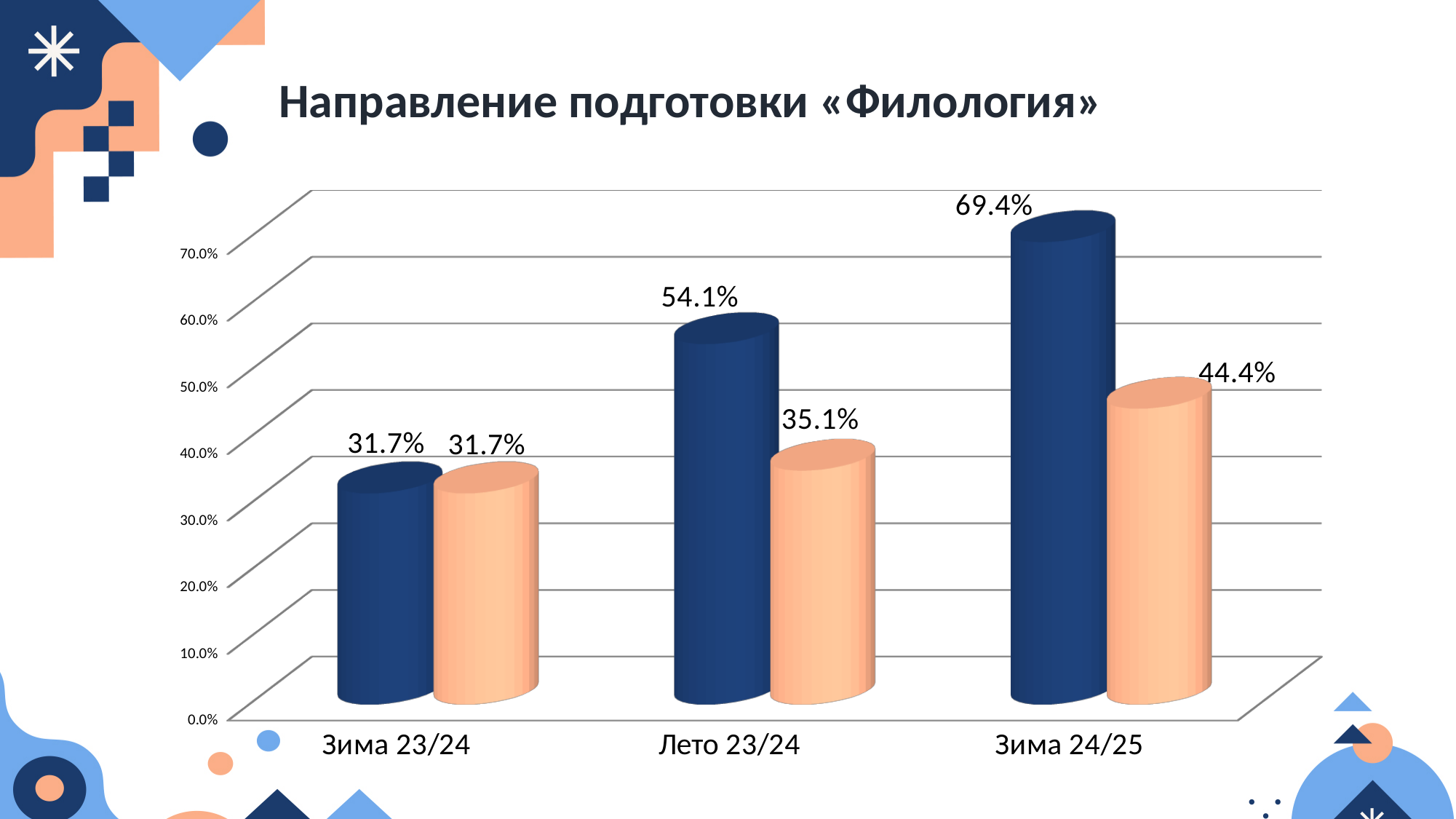
What is the title of the slide? Направление подготовки «Филология» What is the difference between the dark blue and orange bars for Зима 24/25? 25.0% What is the value of the orange bar for Лето 23/24? 35.1% Do the dark blue bar values rise or fall from Зима 23/24 to Зима 24/25? rise What is the value of the dark blue bar for Зима 24/25? 69.4% What is the value of the orange bar for Зима 24/25? 44.4% Which category has the lowest orange bar? Зима 23/24 Which category has the highest dark blue bar? Зима 24/25 Which is larger for Лето 23/24, the dark blue bar or the orange bar? the dark blue bar How many categories are shown on the x axis? 3 What type of chart is shown on the slide? bar chart What is the value of the dark blue bar for Лето 23/24? 54.1%